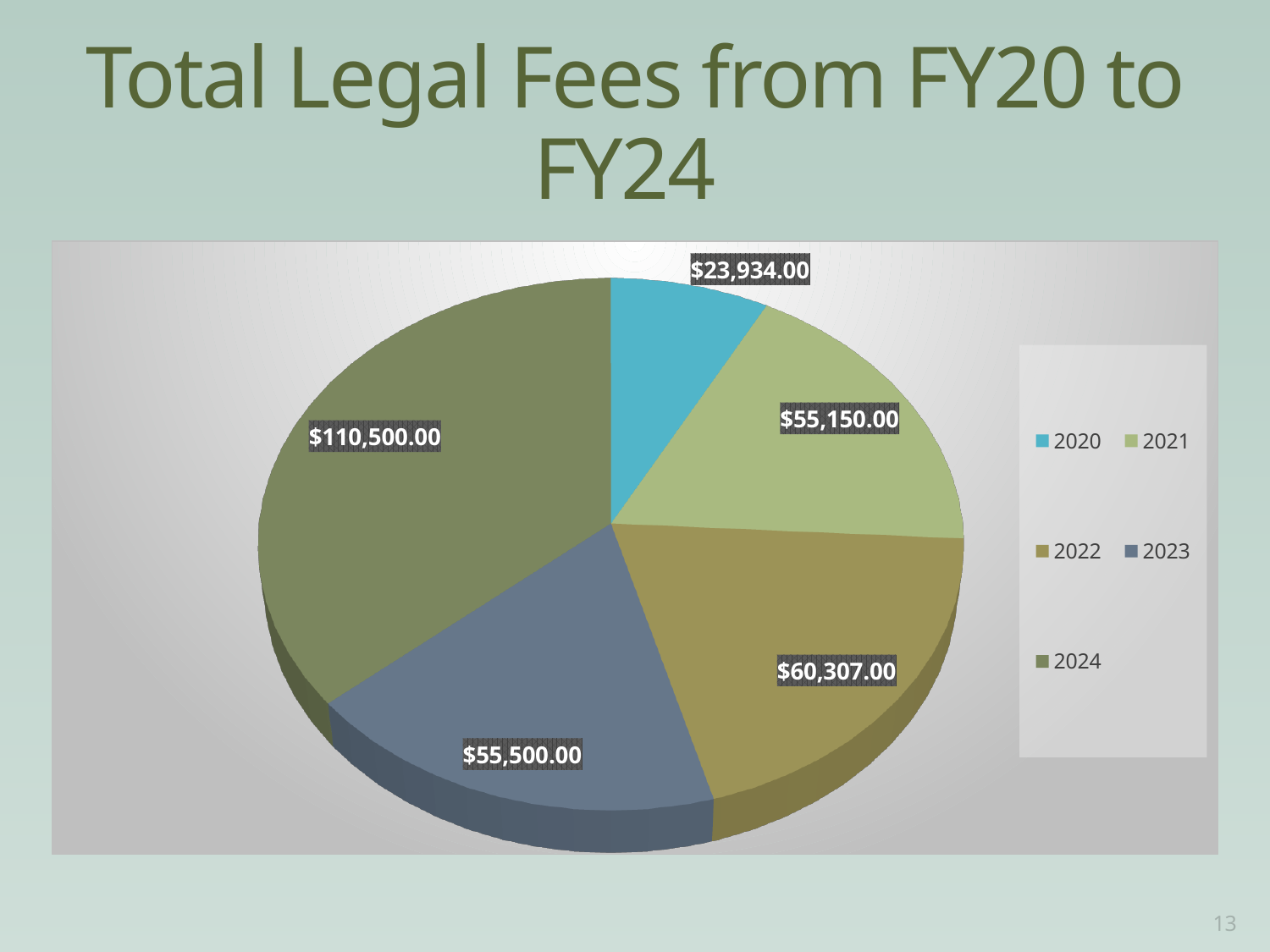
What is the total legal fees value for 2023? $55,500.00 How many slices does the pie chart have? 5 How much greater are the legal fees for 2024 than for 2020? $86,566.00 What is the difference between the legal fees for 2022 and 2021? $5,157.00 What is the total legal fees value for 2020? $23,934.00 What is the total legal fees value for 2022? $60,307.00 What type of chart is shown on the slide? Pie chart Which year has the smallest slice of the pie? 2020 Which year has the largest slice of the pie? 2024 What is the total legal fees value for 2024? $110,500.00 Which year had higher legal fees, 2022 or 2023? 2022 What is the title of the slide containing the pie chart? Total Legal Fees from FY20 to FY24